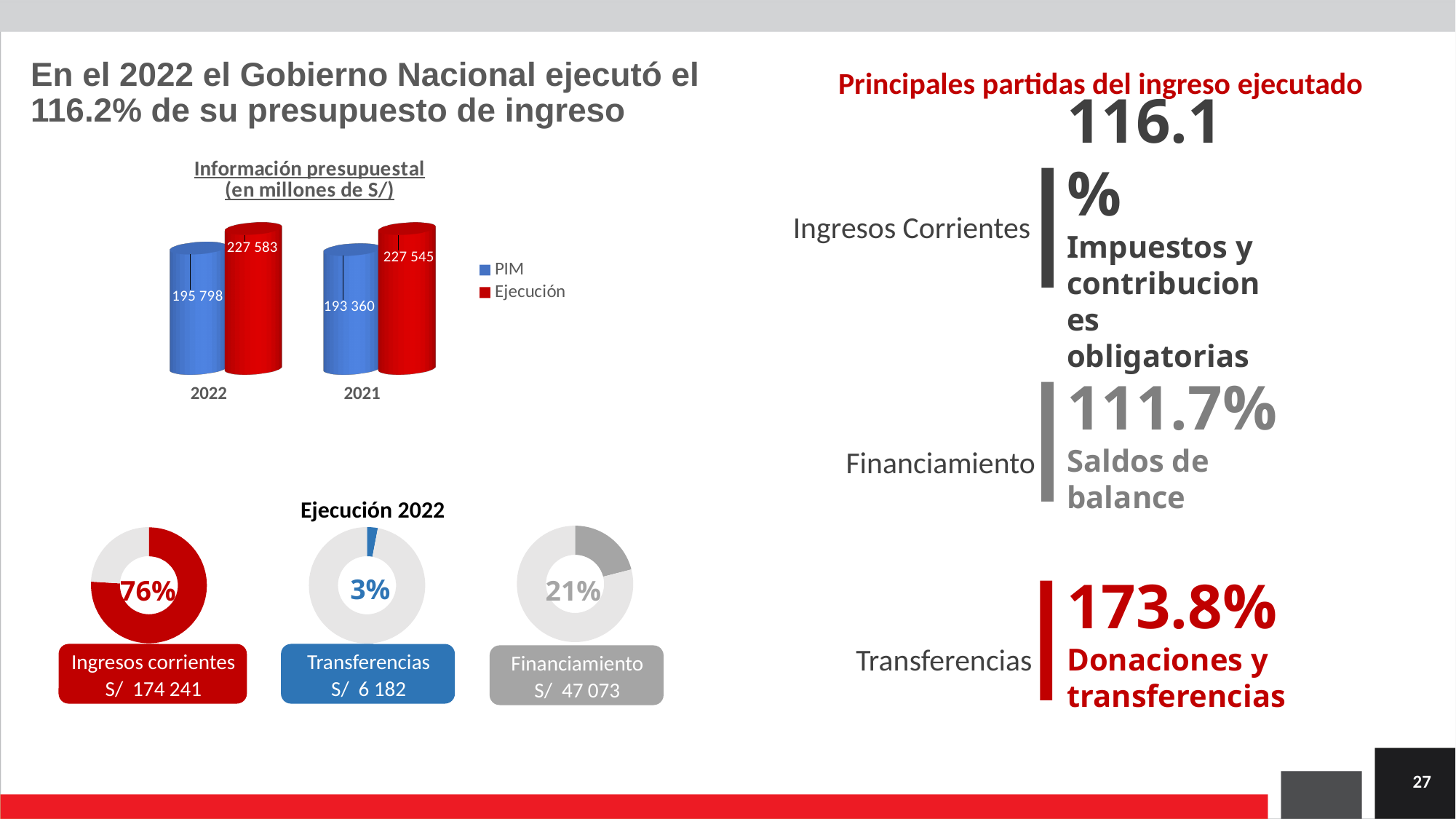
What kind of chart is the 'Información presupuestal (en millones de S/)' chart? Bar chart In the 'Información presupuestal (en millones de S/)' chart, what is the Ejecución value for 2022? 227 583 In the 'Ejecución 2022' donut charts, what share is shown for Ingresos corrientes? 76% In the 'Información presupuestal (en millones de S/)' chart, how many series does the legend list? 2 In the 'Información presupuestal (en millones de S/)' chart, how many years are shown on the x axis? 2 In the 'Información presupuestal (en millones de S/)' chart, what is the PIM value for 2021? 193 360 In the 'Ejecución 2022' donut charts, what share is shown for Transferencias? 3% In the 'Información presupuestal (en millones de S/)' chart, what is the PIM value for 2022? 195 798 In the 'Información presupuestal (en millones de S/)' chart, which is larger in 2021, PIM or Ejecución? Ejecución In the 'Información presupuestal (en millones de S/)' chart, what is the difference between Ejecución and PIM in 2022? 31 785 In the 'Ejecución 2022' donut charts, which category has the lowest share? Transferencias In the 'Ejecución 2022' donut charts, what amount in S/ is shown for Financiamiento? S/ 47 073